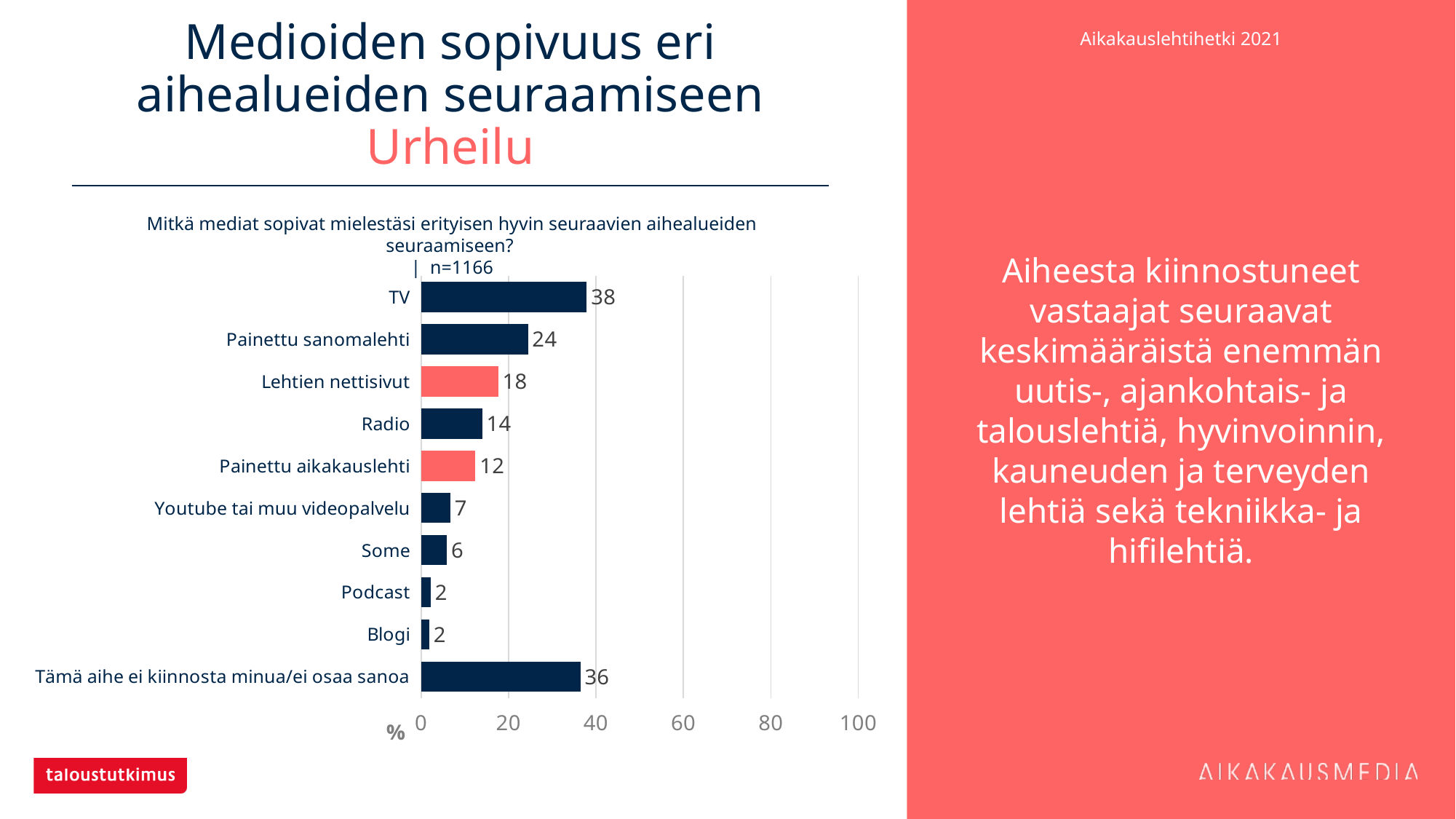
How many categories are shown in the chart? 10 What is the value for Some? 6 What is the sample size (n) stated above the chart? n=1166 Is the value for Painettu sanomalehti greater or less than 20? greater What is the value for Lehtien nettisivut? 18 Which category has the highest value? TV What is the value for Painettu sanomalehti? 24 What is the value for Tämä aihe ei kiinnosta minua/ei osaa sanoa? 36 What is the value for TV? 38 Which is larger, the value for Radio or the value for Painettu aikakauslehti? Radio What kind of chart is shown on the slide? bar chart What is the difference between the values for TV and Painettu sanomalehti? 14